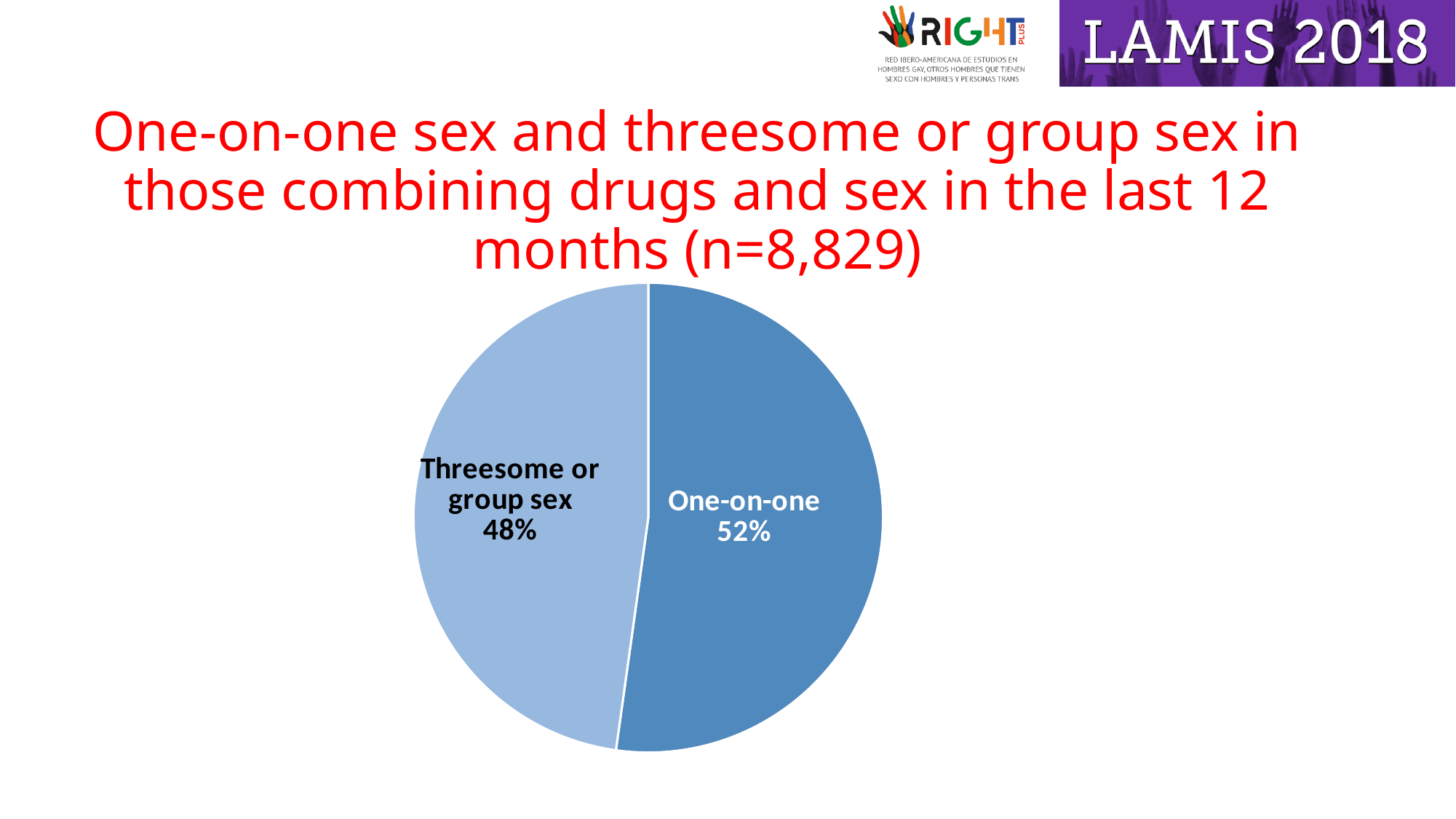
Which slice of the pie is the smallest? Threesome or group sex Which slice of the pie is the largest? One-on-one What share of the pie is labelled Threesome or group sex? 48% What share of the pie is labelled One-on-one? 52% What is the difference in percentage points between the One-on-one slice and the Threesome or group sex slice? 4 percentage points Which is larger: the One-on-one slice or the Threesome or group sex slice? One-on-one Which slice is shown in the darker blue colour? One-on-one How many slices does the pie chart have? 2 What is the sample size (n) given in the slide title? 8,829 Is the share for Threesome or group sex greater or less than 50%? less What kind of chart is shown on the slide? Pie chart